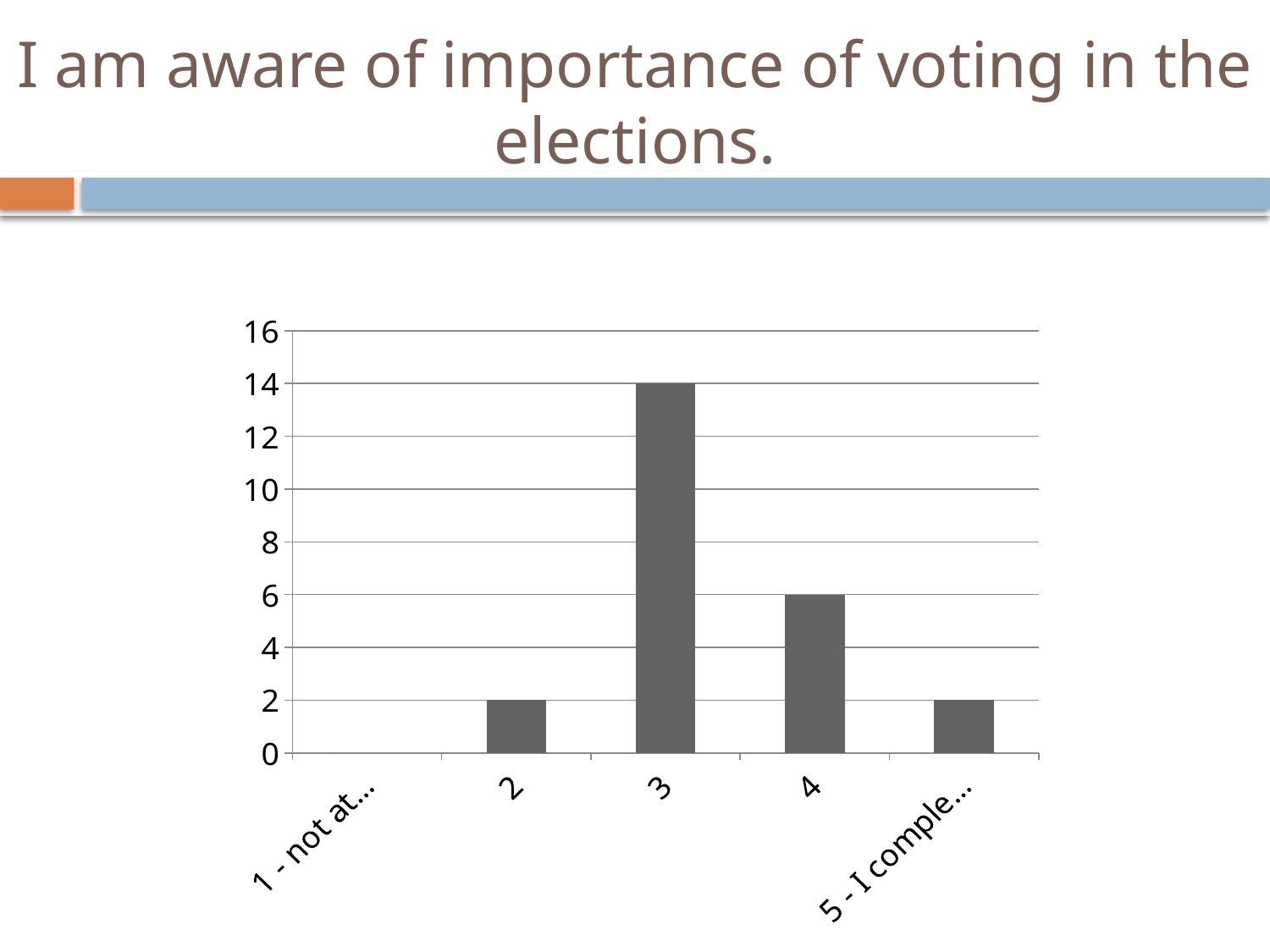
What is the highest value shown on the y axis? 16 Which is larger, the value for category 4 or the value for category 2? 4 What is the value for category 4? 6 Which category has the highest value? 3 What is the difference between the values for category 3 and category 4? 8 What type of chart is shown on the slide? bar chart Is the value for category 4 greater or less than 8? less What is the title of the slide containing the chart? I am aware of importance of voting in the elections. How many categories are shown on the x axis? 5 What is the value for category 3? 14 What is the value for category 2? 2 Is the value for category 3 greater or less than 10? greater